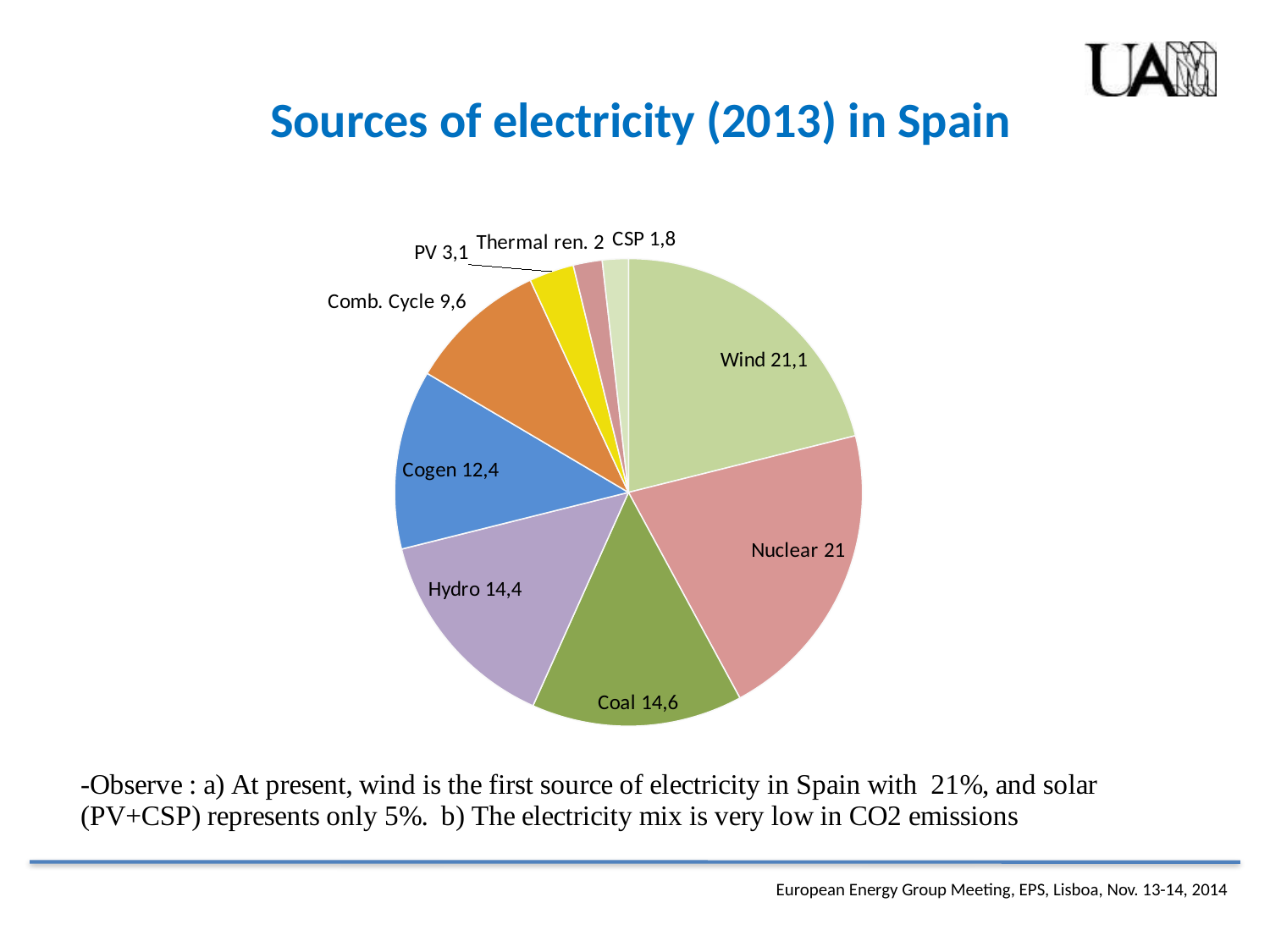
Which is larger, the value for Hydro or the value for Cogen? Hydro Which source has the largest slice in the pie chart? Wind What kind of chart is shown on the slide? Pie chart What is the title of the slide's chart? Sources of electricity (2013) in Spain What is the difference between the values for Cogen and Comb. Cycle? 2,8 What value is shown for Comb. Cycle in the pie chart? 9,6 What value is shown for PV in the pie chart? 3,1 What value is shown for Hydro in the pie chart? 14,4 Which source has the smallest slice in the pie chart? CSP What value is shown for Wind in the pie chart? 21,1 What share of the pie does Coal represent? 14,6 How many sources (slices) are shown in the pie chart? 9